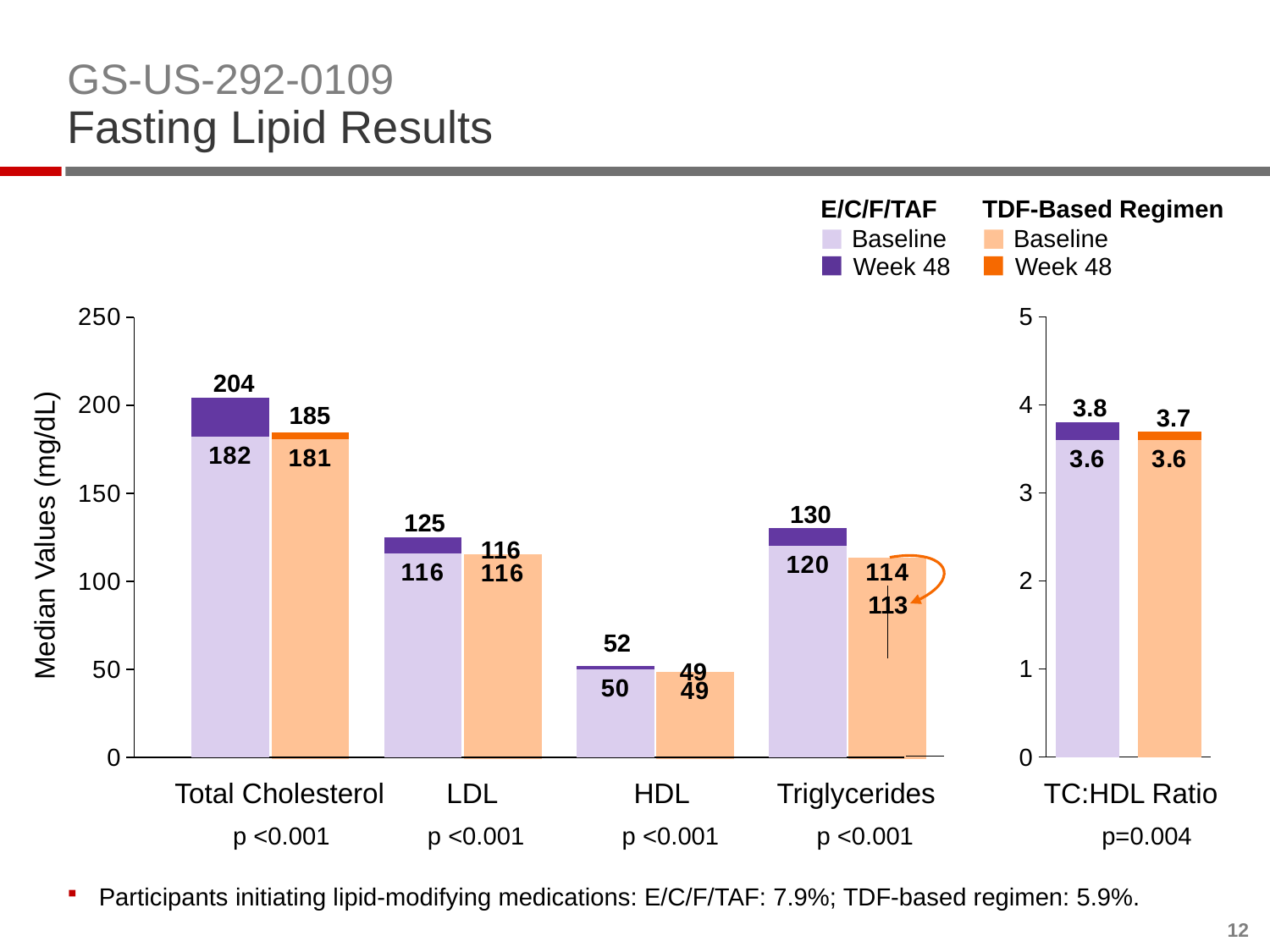
On the left chart, what is the difference between the E/C/F/TAF Week 48 and baseline median Total Cholesterol values? 22 On the left chart, what is the baseline median LDL value for the TDF-Based Regimen? 116 What type of chart is used on this slide? Bar chart On the left chart, what is the Week 48 median Triglycerides value for the TDF-Based Regimen? 113 On the left chart, which category has the highest baseline value for the TDF-Based Regimen? Total Cholesterol On the left chart, what is the Week 48 median Total Cholesterol value for E/C/F/TAF? 204 How many categories are shown on the x axis of the left chart? 4 On the left chart, which is larger: the Week 48 Triglycerides value for E/C/F/TAF or for the TDF-Based Regimen? E/C/F/TAF On the left chart, is the E/C/F/TAF Week 48 Total Cholesterol value greater or less than 200? greater On the left chart, which category has the lowest Week 48 value for E/C/F/TAF? HDL How many series does the legend list? 4 On the right chart, what is the Week 48 TC:HDL Ratio for E/C/F/TAF? 3.8